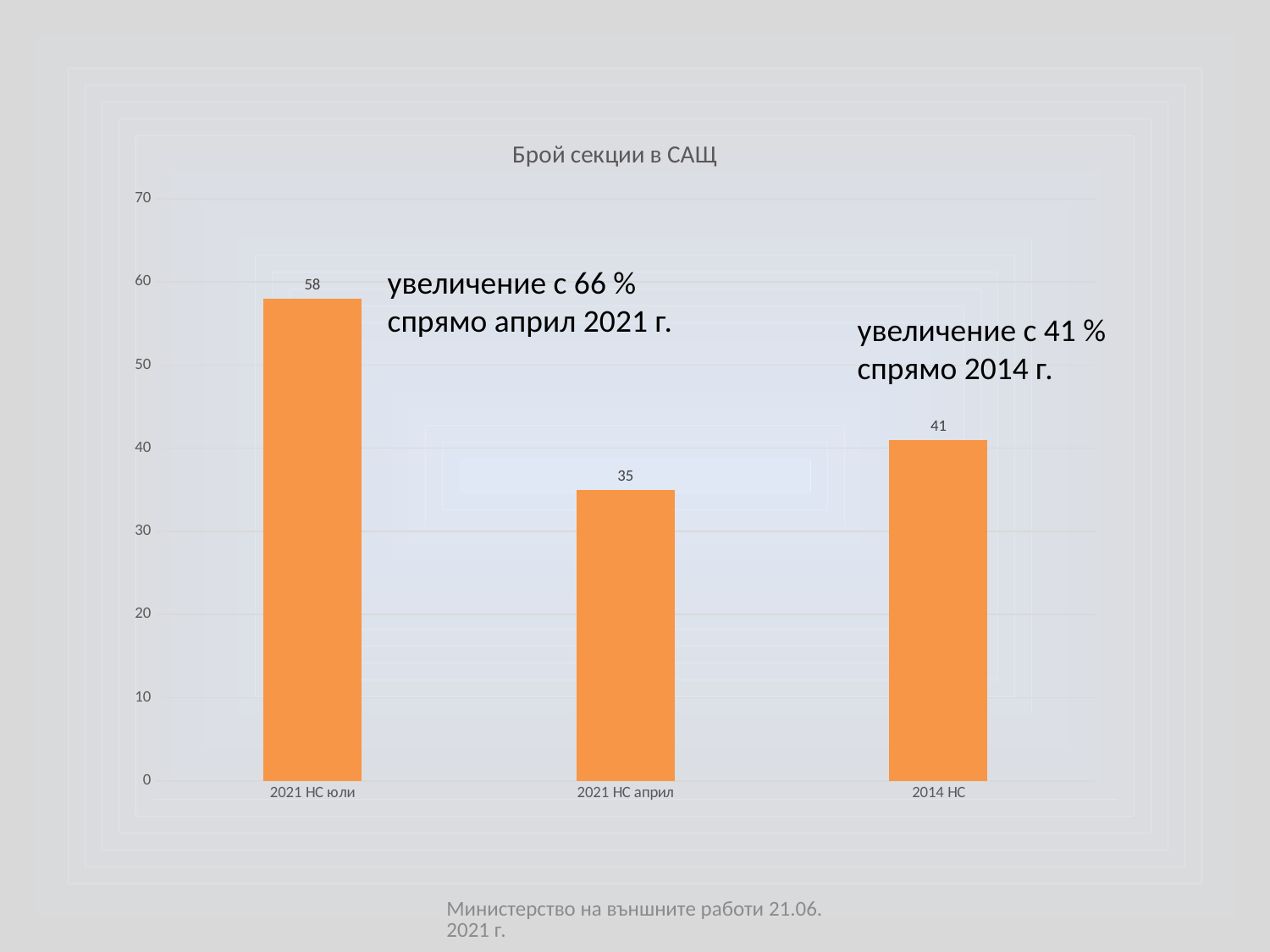
Which category has the lowest value? 2021 НС април What is the value for 2014 НС? 41 Is the value for 2021 НС юли greater or less than 50? greater What kind of chart is shown on the slide? bar chart How many categories are shown on the x axis? 3 What is the difference between the values for 2014 НС and 2021 НС април? 6 What is the value for 2021 НС април? 35 Which is larger, the value for 2014 НС or the value for 2021 НС април? 2014 НС What is the difference between the values for 2021 НС юли and 2021 НС април? 23 What is the value for 2021 НС юли? 58 Which category has the highest value? 2021 НС юли What is the title of the chart? Брой секции в САЩ